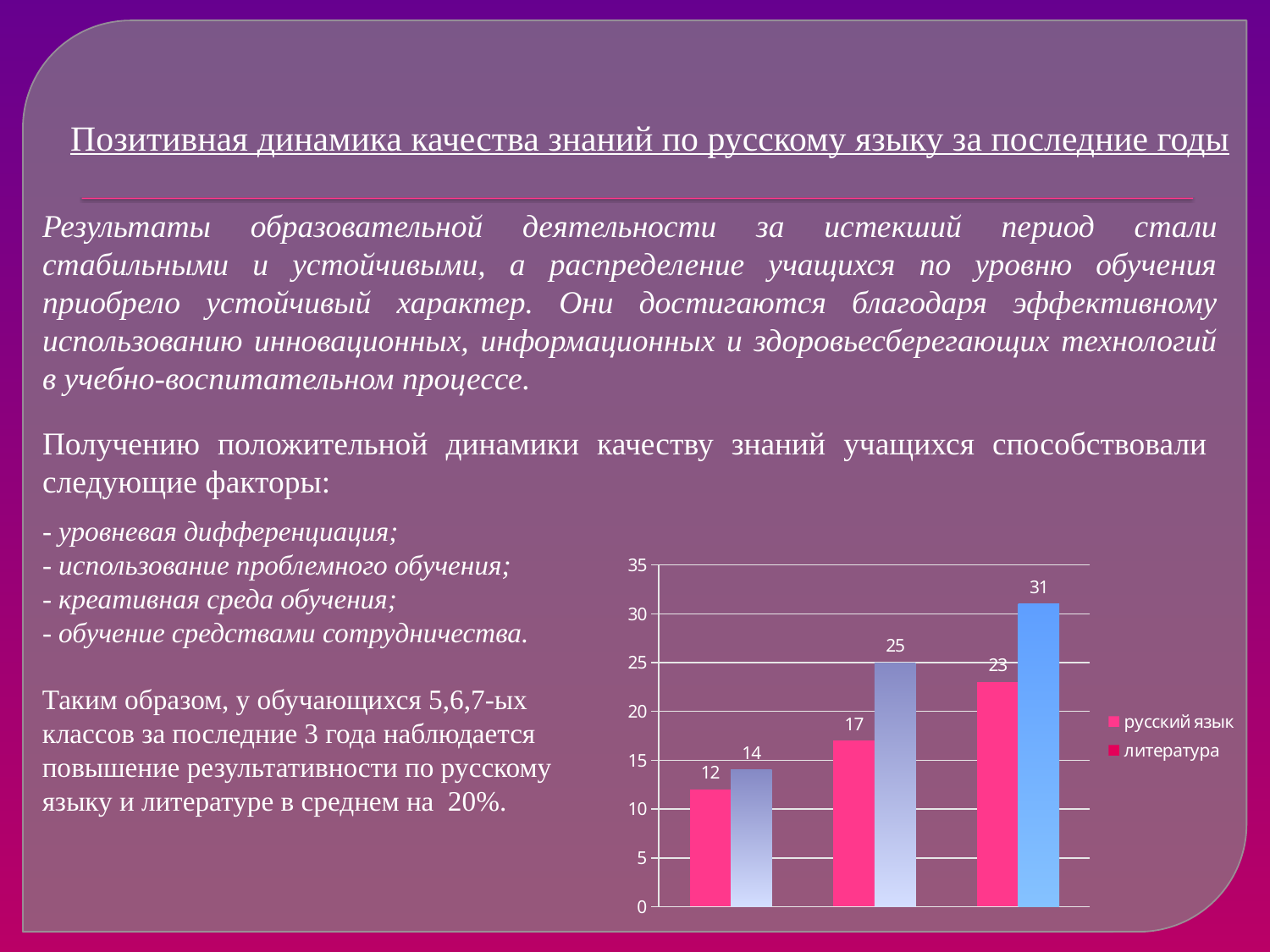
What kind of chart is shown on the slide? bar chart What is the value of the литература bar in the second (middle) group? 25 Which bar has the highest value in the chart? литература in the third group (31) What is the value of the русский язык bar in the first (leftmost) group? 12 What are the two series named in the chart legend? русский язык, литература In the second (middle) group, which series has the larger value, русский язык or литература? литература What is the difference between the литература and русский язык values in the third (rightmost) group? 8 What is the value of the литература bar in the third (rightmost) group? 31 How many groups of bars are plotted in the chart? 3 How many series does the chart legend list? 2 Which bar has the lowest value in the chart? русский язык in the first group (12) Do the русский язык values rise or fall from the first group to the third group? rise